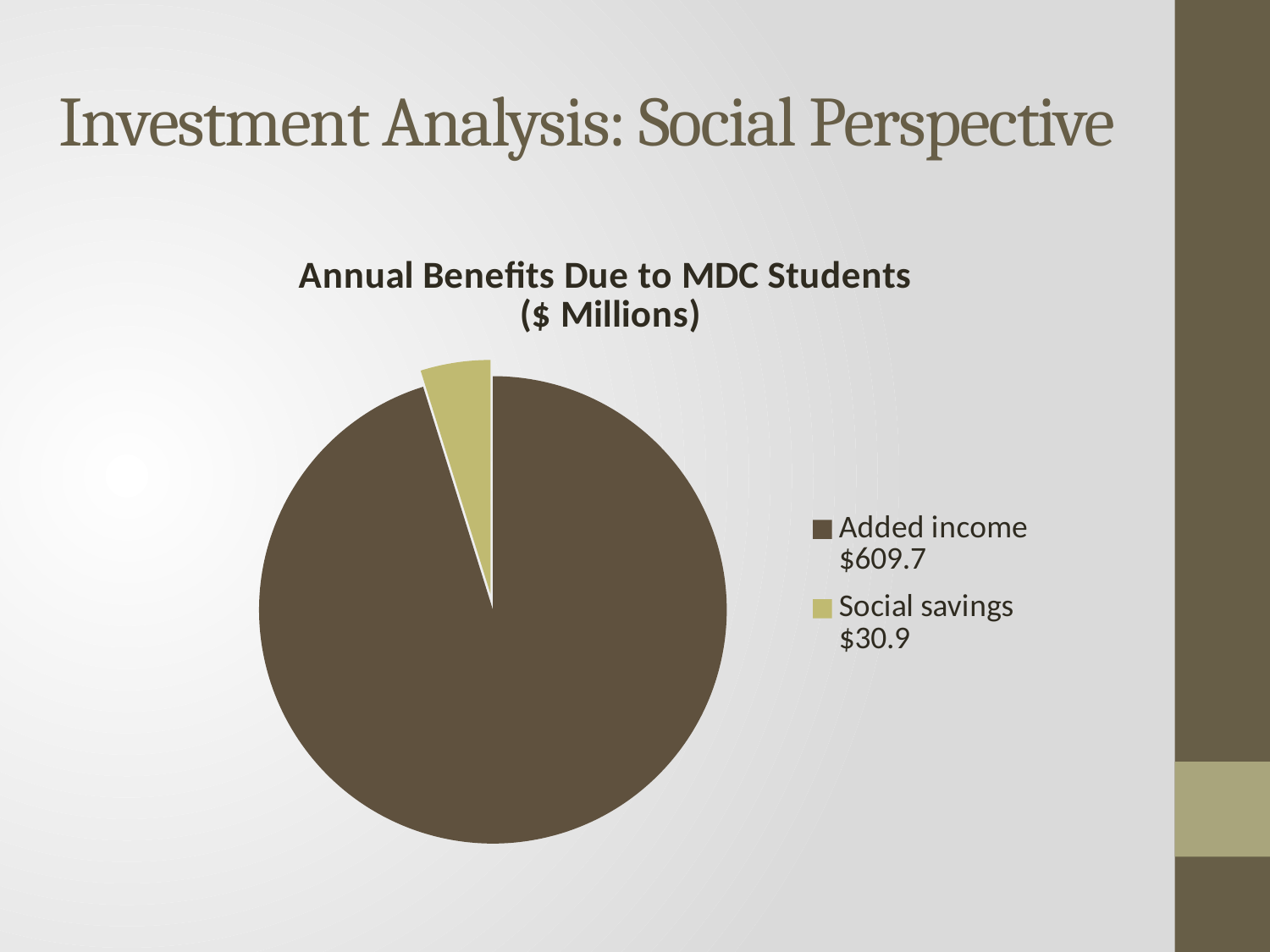
What is the total of Added income and Social savings? $640.6 What type of chart is shown on the slide? Pie chart What is the value for Added income? $609.7 Which category has the smallest slice of the pie? Social savings What is the value for Social savings? $30.9 What is the title of the chart? Annual Benefits Due to MDC Students ($ Millions) Which category has the largest slice of the pie? Added income What colour is the Social savings slice? Light olive/khaki How many slices does the pie chart have? 2 How many entries does the legend list? 2 What is the difference between Added income and Social savings? $578.8 Which is larger, Added income or Social savings? Added income